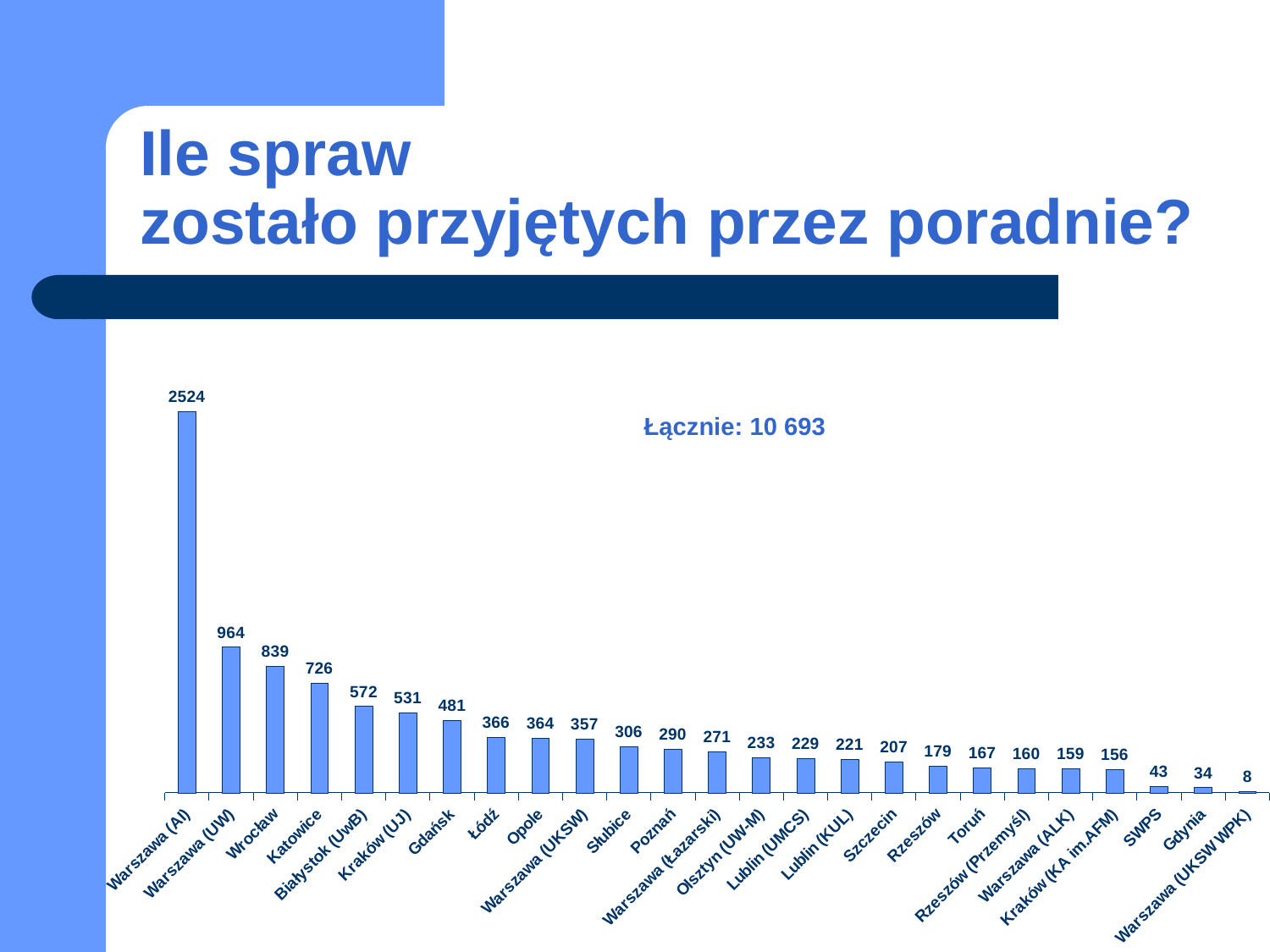
Which category has the highest value? Warszawa (AI) What kind of chart is shown on the slide? Bar chart What value is shown for Wrocław? 839 Which category has the lowest value? Warszawa (UKSW WPK) Do the values rise or fall from left to right along the x axis? Fall Which is larger, the value for Gdańsk or the value for Słubice? Gdańsk What is the difference between the values for Warszawa (UW) and Katowice? 238 How many cases does the chart show for Warszawa (AI)? 2524 What value is shown for Gdynia? 34 What value is shown for Lublin (KUL)? 221 What total (Łącznie) is printed on the chart? 10 693 How many categories are shown on the x axis? 25